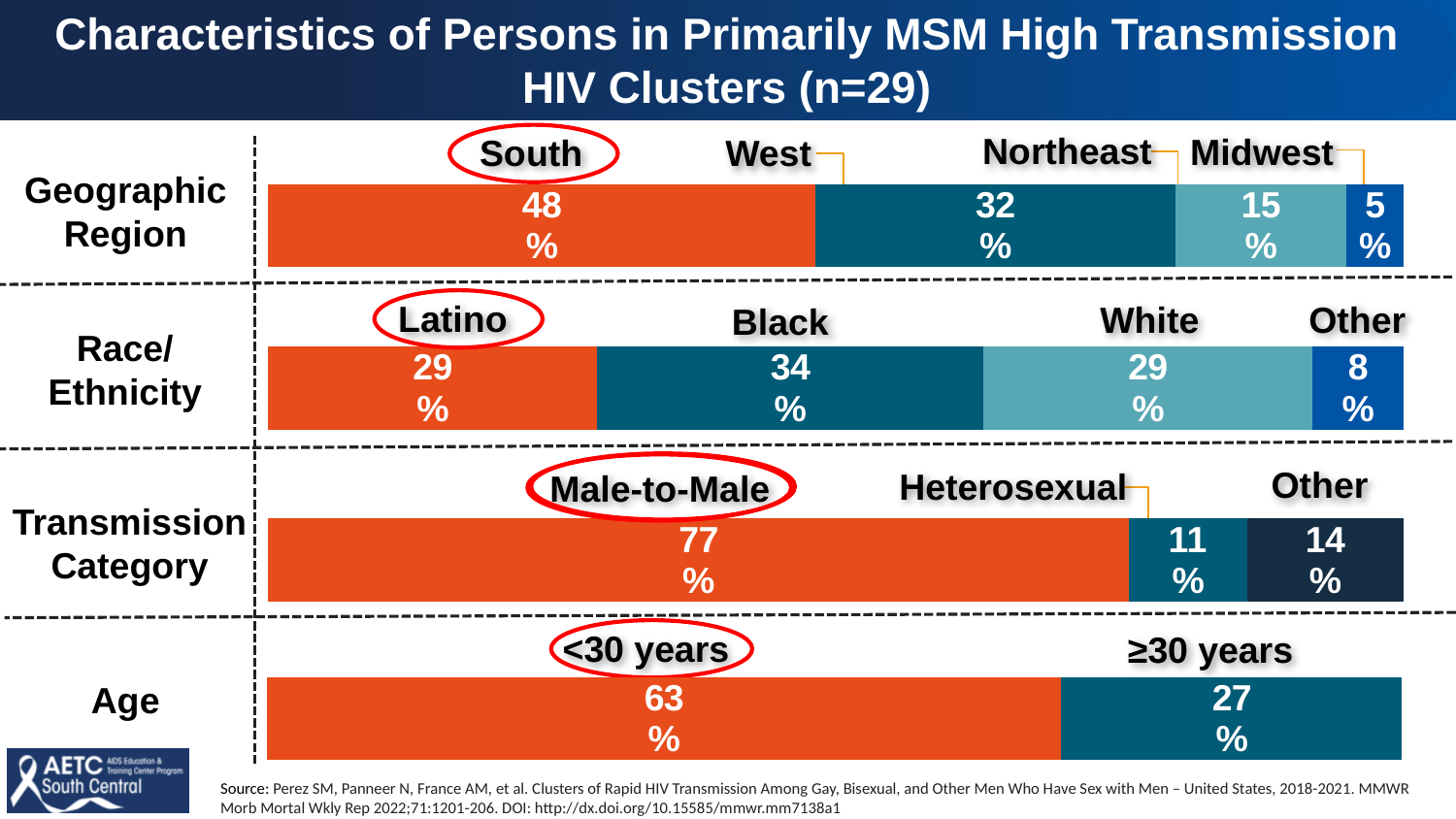
In the Transmission Category bar, what percentage is shown for Male-to-Male? 77% How many segments does the Race/Ethnicity bar have? 4 What kind of chart is used on this slide? Stacked bar chart In the Geographic Region bar, what percentage is shown for the South? 48% In the Race/Ethnicity bar, what percentage is shown for Black? 34% In the Age bar, what percentage is shown for ≥30 years? 27% In the Geographic Region bar, what is the difference between the South and West percentages? 16% In the Geographic Region bar, which region has the lowest percentage? Midwest In the Race/Ethnicity bar, which group has the highest percentage? Black In the Transmission Category bar, which is larger, Heterosexual or Other? Other In the Age bar, what is the difference between the <30 years and ≥30 years percentages? 36% Which category in the Transmission Category bar is circled in red? Male-to-Male